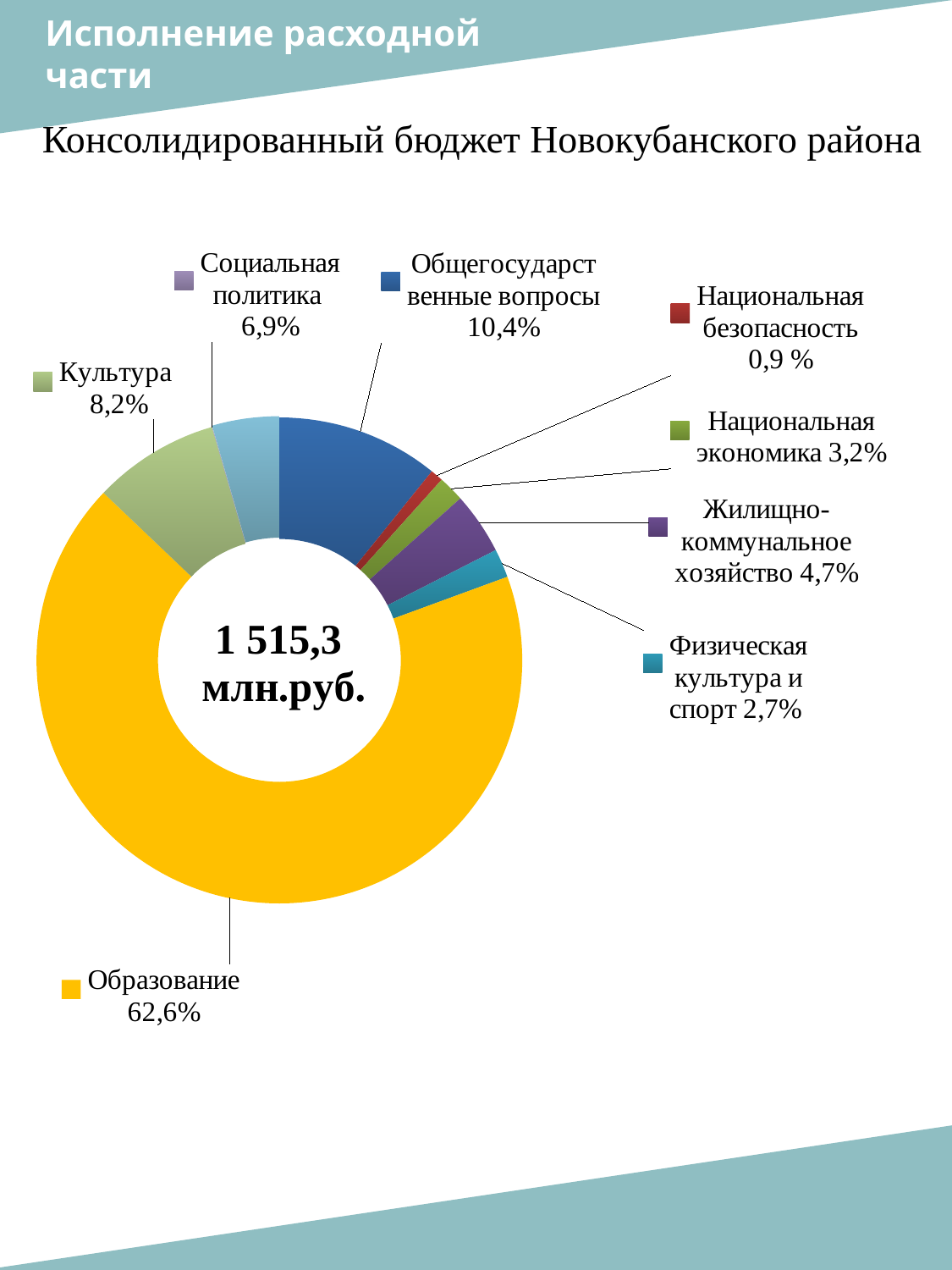
What share of the budget goes to Национальная безопасность? 0,9 % What share of the budget goes to Общегосударственные вопросы? 10,4% What share of the budget goes to Культура? 8,2% What share of the budget goes to Образование? 62,6% Which category has the smallest share of the budget? Национальная безопасность Which category has the largest share of the budget? Образование What kind of chart is shown on the slide? Pie (doughnut) chart What total amount is shown in the centre of the chart? 1 515,3 млн.руб. How many categories are shown in the chart? 8 Which is larger: the share for Социальная политика or for Культура? Культура What share of the budget goes to Жилищно-коммунальное хозяйство? 4,7% What is the difference in percentage points between Общегосударственные вопросы and Национальная экономика? 7,2